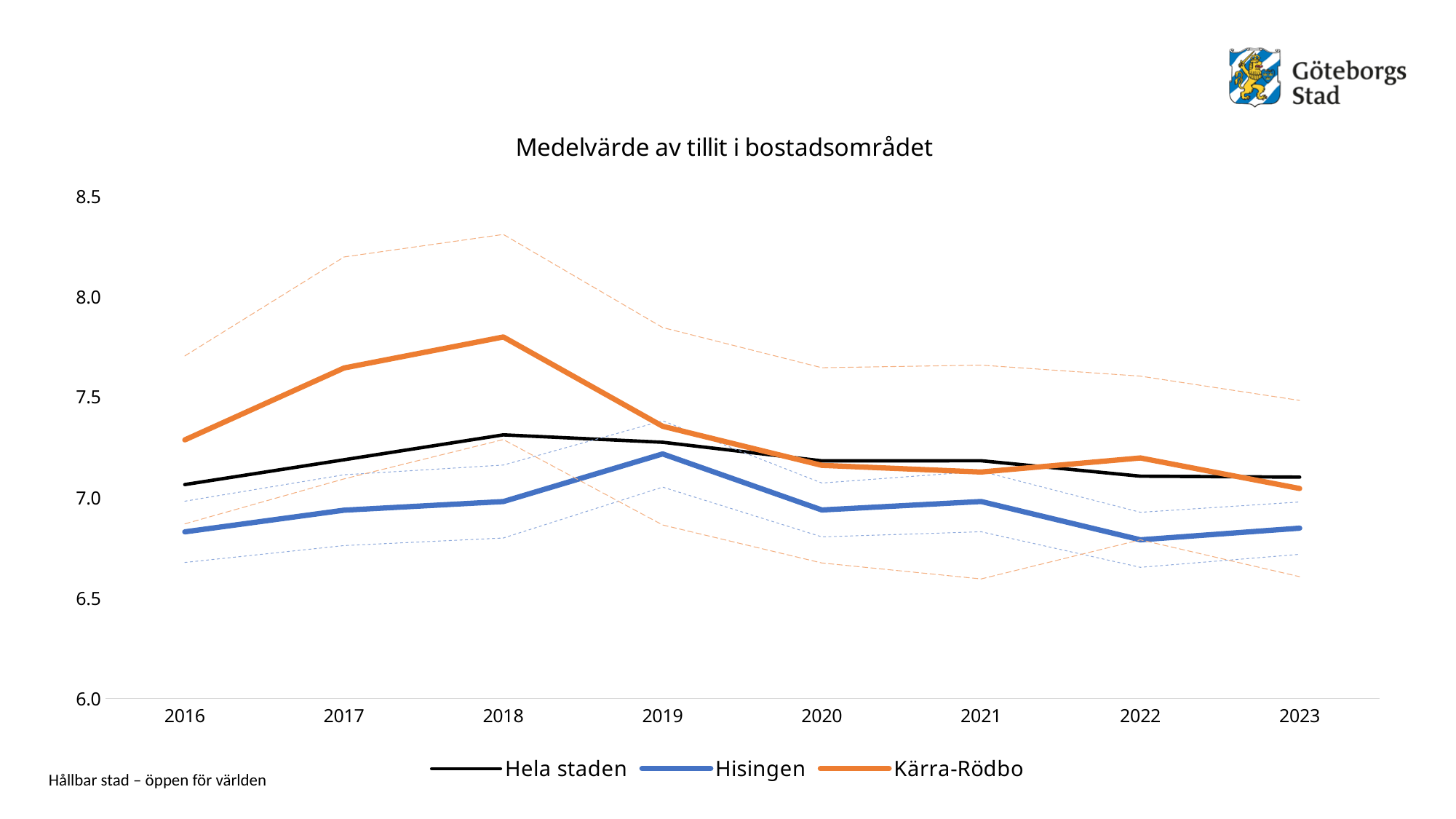
Which colour is used for the Kärra-Rödbo line? orange How many years are shown on the x axis? 8 What is the title of the chart? Medelvärde av tillit i bostadsområdet How many series does the legend list? 3 In which year does the Hisingen line reach its highest value? 2019 Does the Kärra-Rödbo line rise or fall from 2018 to 2023? fall Which series has the higher value in 2017, Kärra-Rödbo or Hisingen? Kärra-Rödbo What kind of chart is shown on the slide? line chart Which series has the lowest value in 2023? Hisingen Is the value for Kärra-Rödbo in 2018 greater or less than 7.5? greater In which year does the Kärra-Rödbo line reach its highest value? 2018 Is the value for Hisingen in 2016 greater or less than 7.0? less